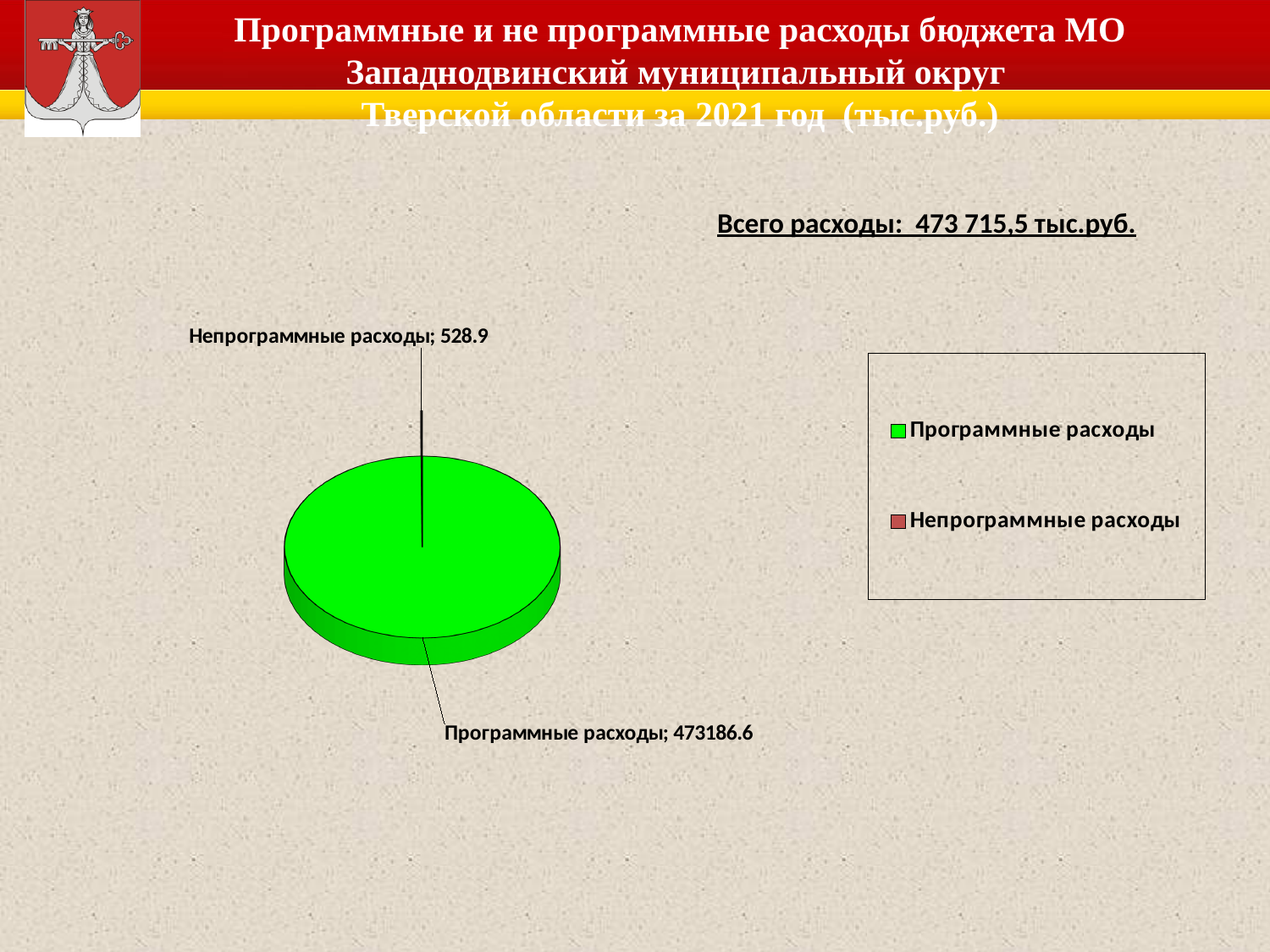
What is the value for Программные расходы? 473186.6 What colour is the Программные расходы slice? Green What is the difference between Программные расходы and Непрограммные расходы? 472657.7 What type of chart is shown on the slide? Pie chart Which is larger, Программные расходы or Непрограммные расходы? Программные расходы Which category has the smallest value? Непрограммные расходы What is the total of the two slices in the pie chart? 473715.5 Which category has the largest value? Программные расходы What total expenditure figure is stated on the slide? 473 715,5 тыс.руб. What is the value for Непрограммные расходы? 528.9 How many entries does the legend list? 2 How many categories are shown in the pie chart? 2